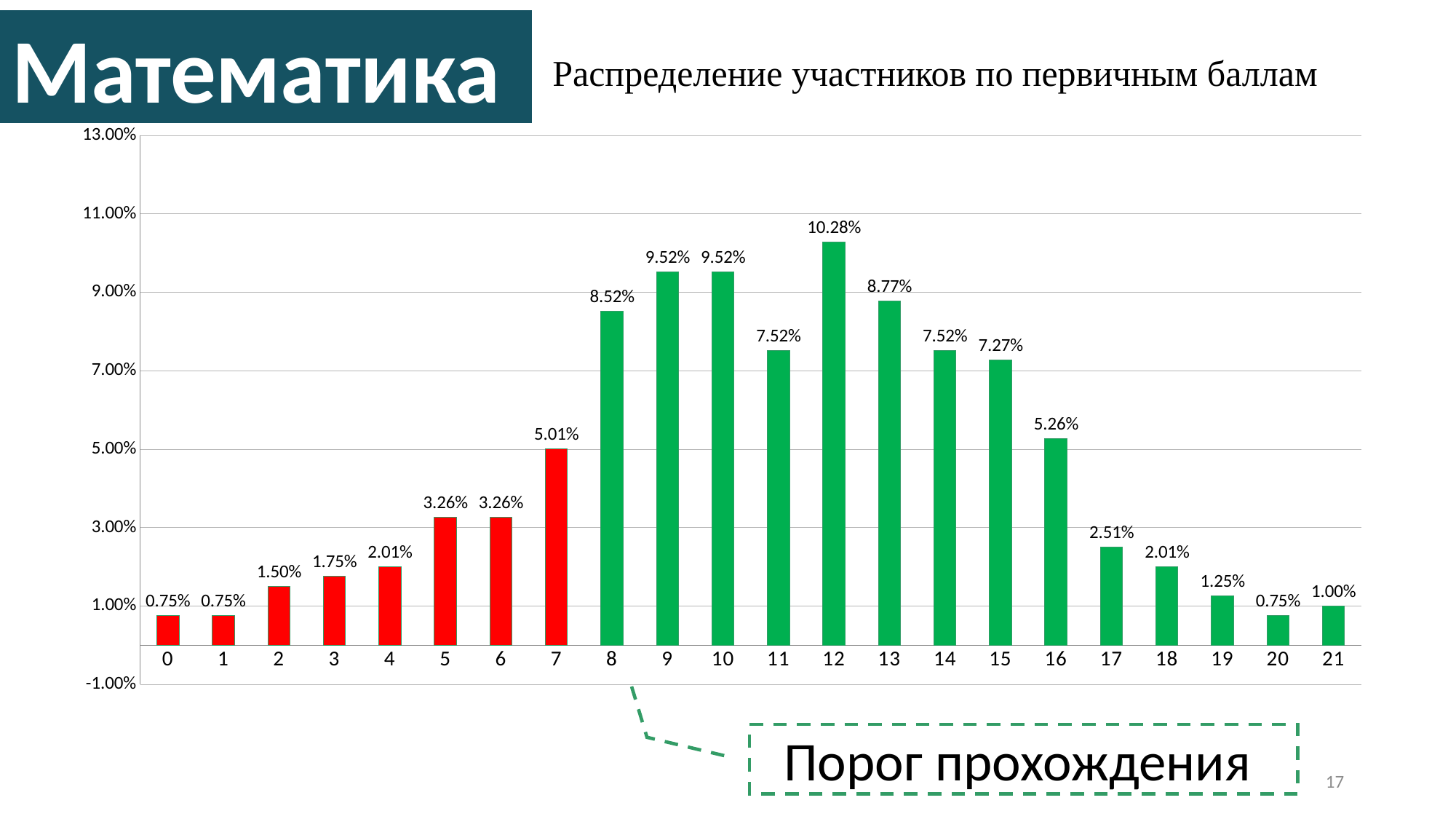
Which primary score has the highest share of participants? 12 At which primary score does the dashed 'Порог прохождения' marker point? 8 Do the values rise or fall from primary score 12 to primary score 20? fall Do the values rise or fall from primary score 0 to primary score 7? rise What type of chart is shown on the slide? bar chart How many primary score categories are shown on the x axis? 22 What is the value for primary score 12? 10.28% What is the value for primary score 7? 5.01% What is the difference between the values for primary scores 12 and 8? 1.76% What is the difference between the values for primary scores 16 and 7? 0.25% What is the value for primary score 16? 5.26% Which is larger, the value for primary score 13 or the value for primary score 11? 13